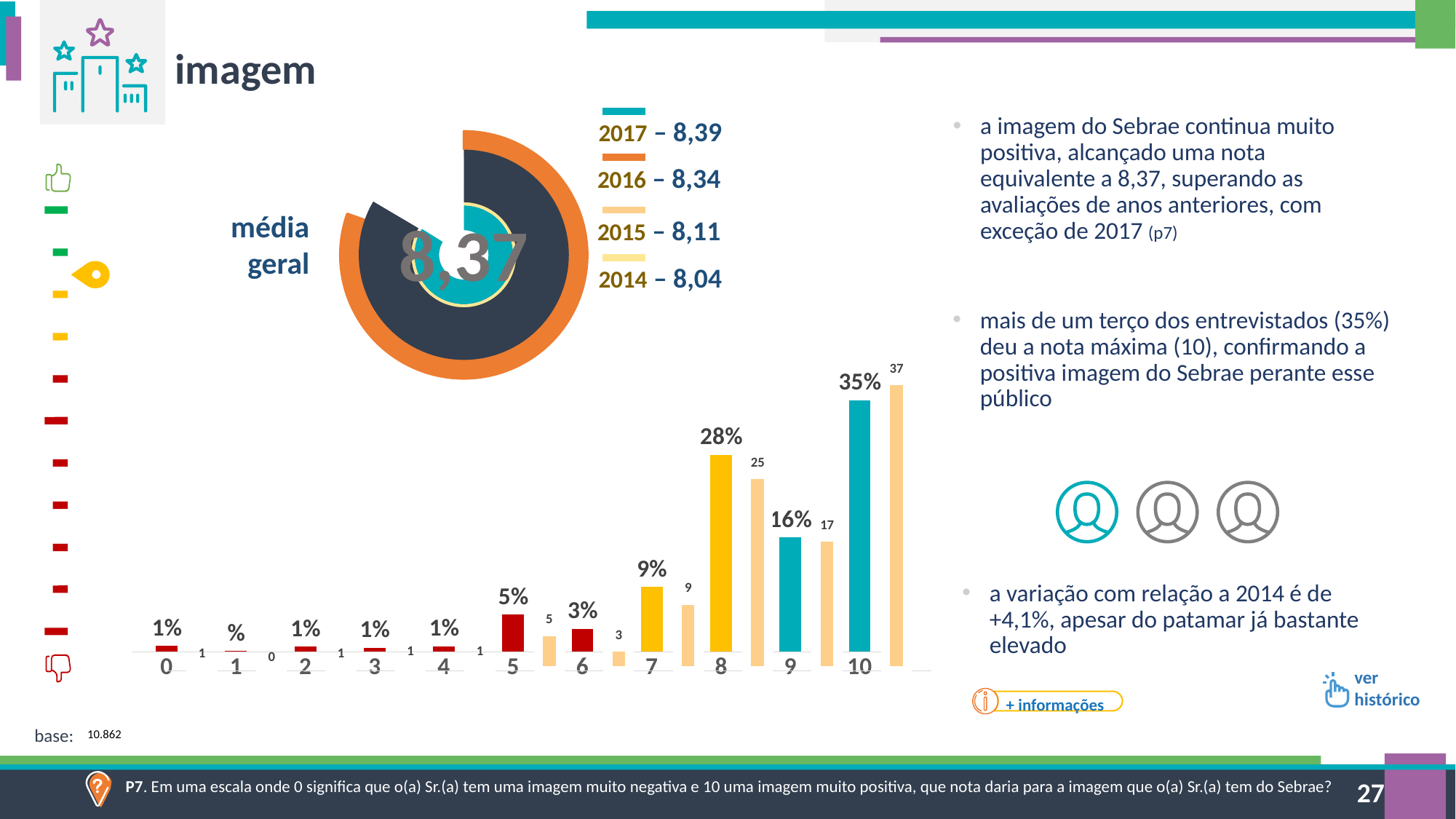
In the bar chart at the bottom of the slide, which score has the highest percentage? 10 What is the média geral value shown in the centre of the radial chart? 8,37 In the bar chart at the bottom of the slide, what percentage is shown for score 8? 28% In the bar chart at the bottom of the slide, what percentage is shown for score 7? 9% In the bar chart at the bottom of the slide, which has a larger percentage, score 9 or score 7? Score 9 In the bar chart at the bottom of the slide, what is the difference between the percentages for score 10 and score 8? 7% In the bar chart at the bottom of the slide, what percentage is shown for score 10? 35% In the bar chart at the bottom of the slide, what is the small number printed next to the light orange bar for score 10? 37 In the média geral chart, what value is shown for 2016? 8,34 In the bar chart at the bottom of the slide, what is the small number printed next to the light orange bar for score 8? 25 How many score categories are shown on the x axis of the bar chart at the bottom of the slide? 11 What type of chart is shown at the bottom of the slide? Bar chart